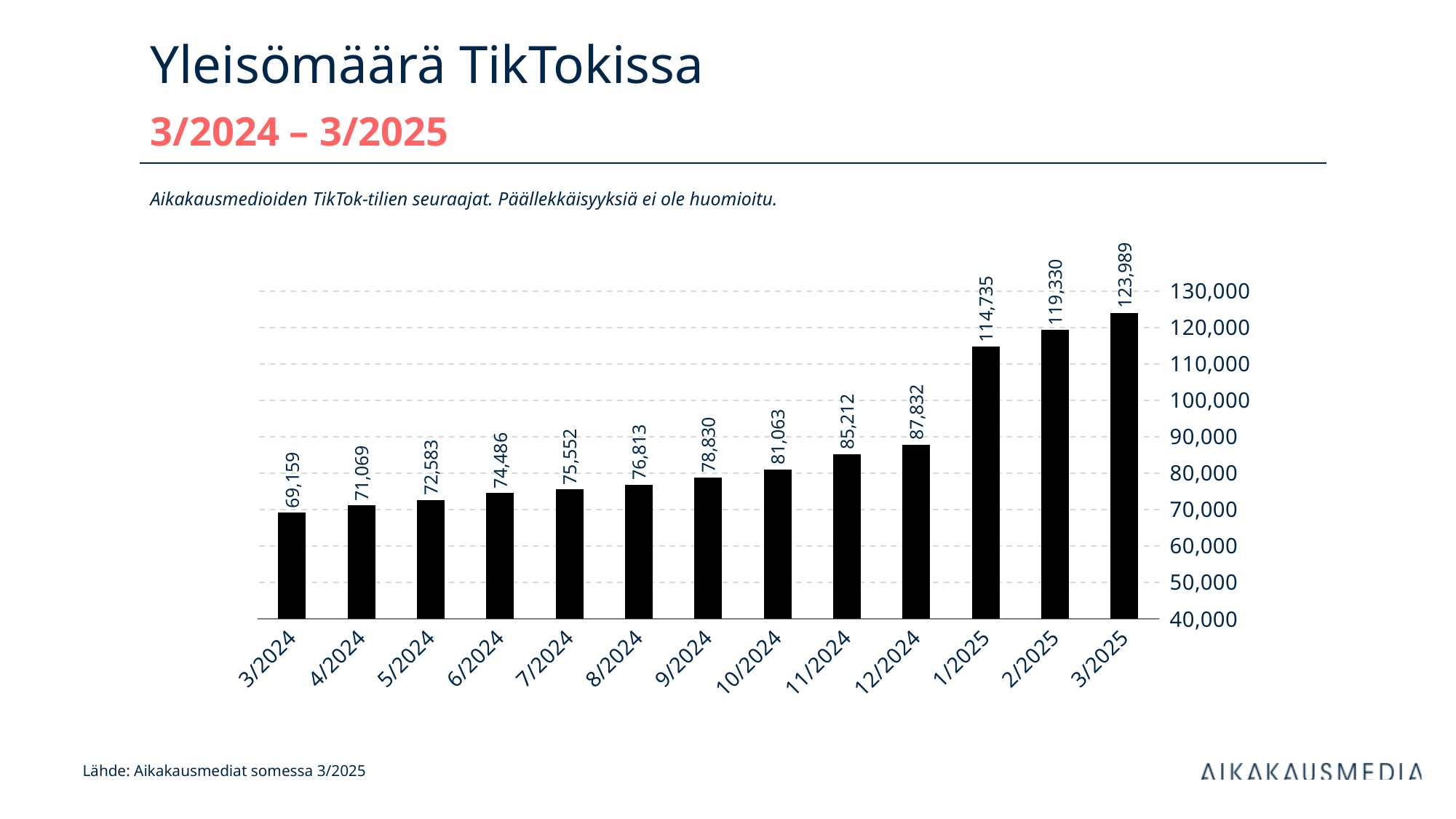
Which month has the lowest value? 3/2024 Which is larger, the value for 2/2025 or the value for 11/2024? 2/2025 How many months are shown on the x axis? 13 What is the difference between the values for 1/2025 and 12/2024? 26,903 What is the difference between the values for 3/2025 and 3/2024? 54,830 Do the values rise or fall from 3/2024 to 3/2025? rise Is the value for 9/2024 greater or less than 80,000? less What is the value for 1/2025? 114,735 What kind of chart is shown on the slide? bar chart What is the value for 3/2024? 69,159 Which month has the highest value? 3/2025 What is the value for 10/2024? 81,063